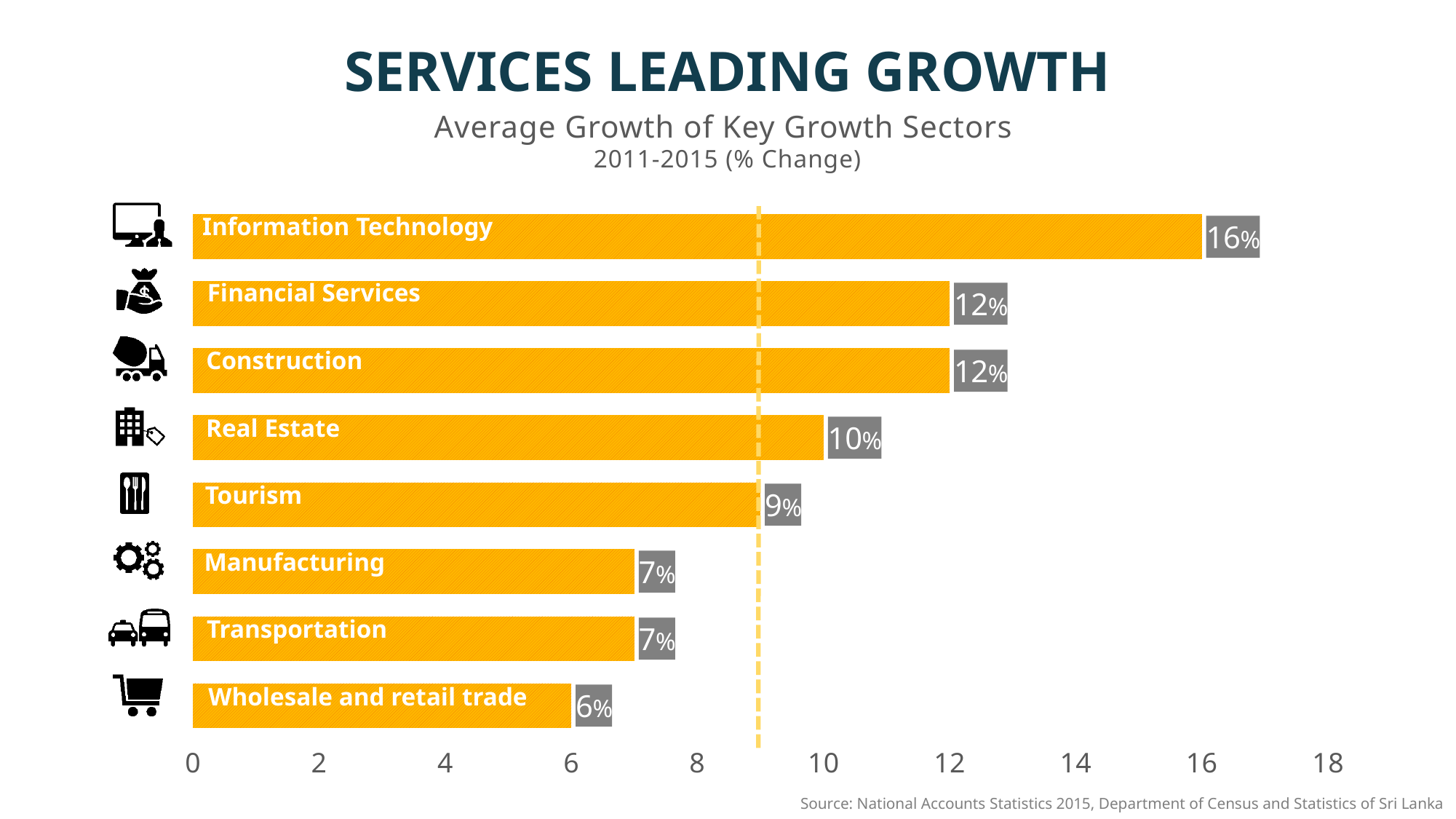
How many sectors are shown in the chart? 8 What is the difference between the values for Real Estate and Manufacturing? 3% Which sector has the lowest average growth? Wholesale and retail trade What kind of chart is shown on the slide? Bar chart What is the average growth value for Information Technology? 16% Which sector has the highest average growth? Information Technology What is the subtitle of the chart below the main heading? Average Growth of Key Growth Sectors 2011-2015 (% Change) What is the average growth value for Real Estate? 10% What is the average growth value for Tourism? 9% What is the difference between the values for Information Technology and Financial Services? 4% Which has a larger value, Construction or Tourism? Construction What is the average growth value for Wholesale and retail trade? 6%